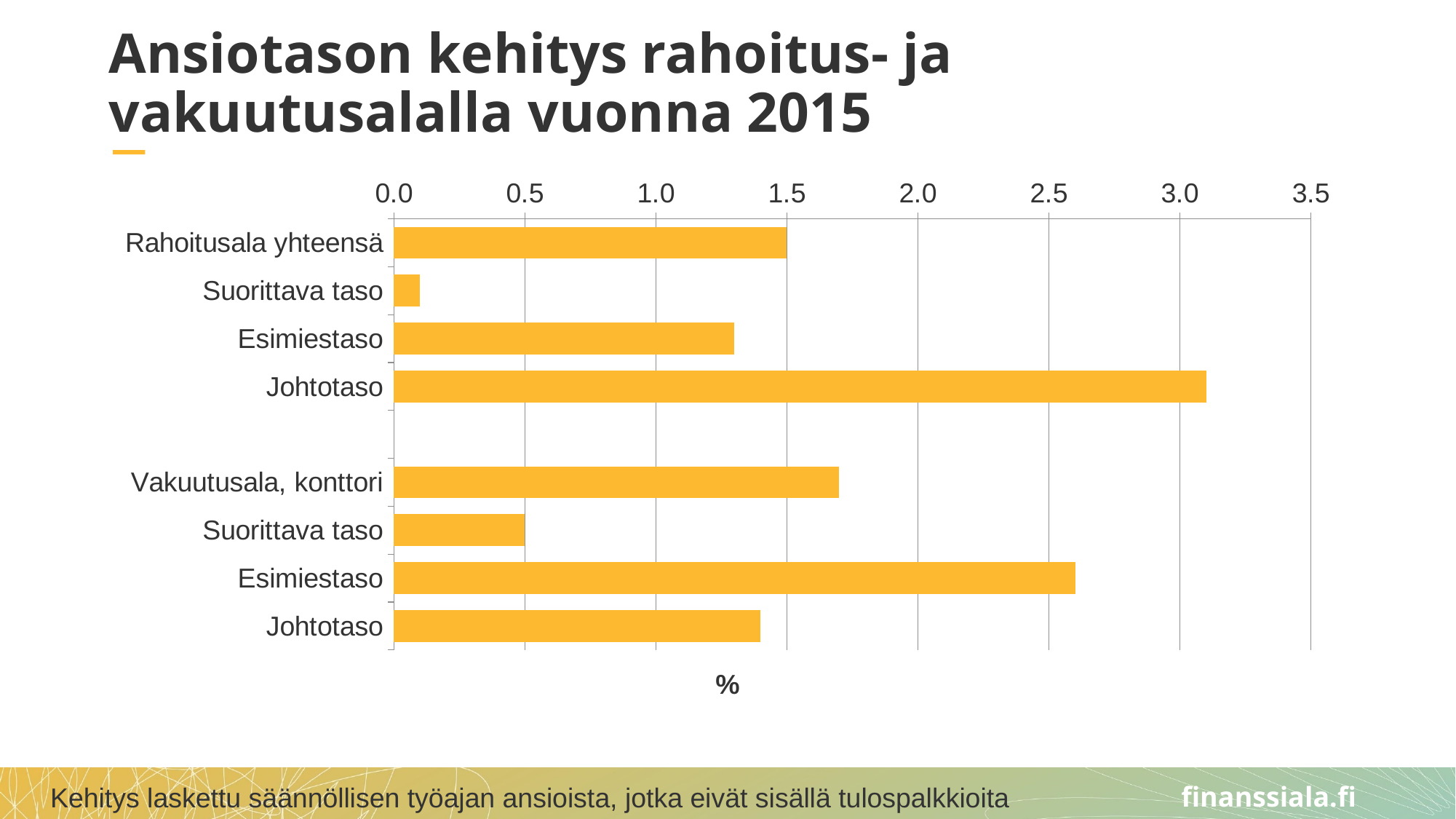
Is the value for Esimiestaso in the Vakuutusala group greater or less than 2.5? greater What kind of chart is shown on the slide? bar chart Which category has the lowest value in the chart? Suorittava taso (under Rahoitusala yhteensä) Is the value for Johtotaso in the Vakuutusala group greater or less than 1.5? less Is the value for Johtotaso in the Rahoitusala group greater or less than 3.0? greater Which category has the highest value in the chart? Johtotaso (under Rahoitusala yhteensä) What unit is shown on the value axis of the chart? % Which is larger: Esimiestaso in the Vakuutusala group or Esimiestaso in the Rahoitusala group? Esimiestaso in the Vakuutusala group How many bars are plotted in the chart? 8 Which is larger: Johtotaso in the Rahoitusala group or Johtotaso in the Vakuutusala group? Johtotaso in the Rahoitusala group